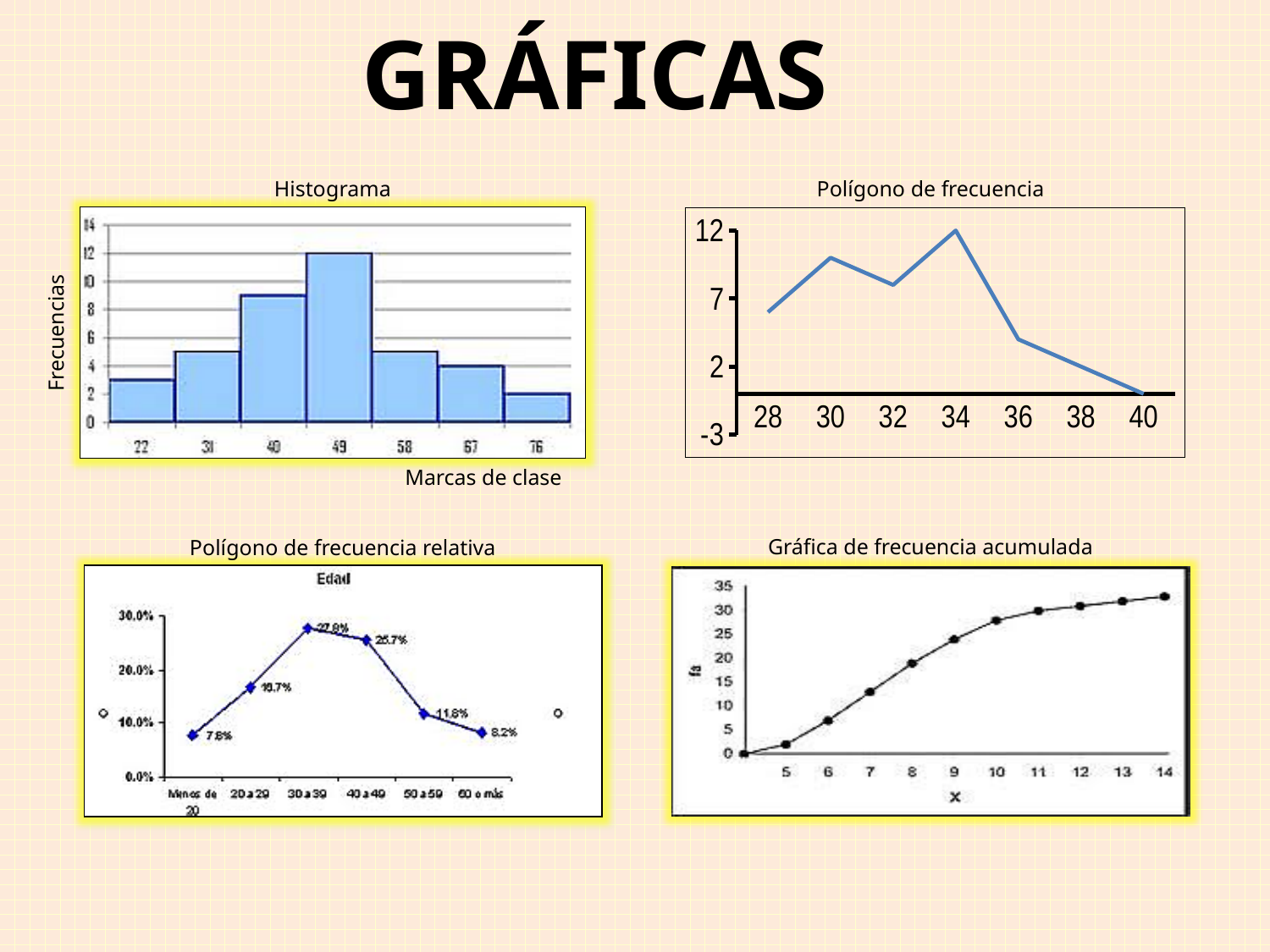
In the Polígono de frecuencia relativa chart, what is the value for the 30 a 39 group? 27.8% In the Histograma chart, what is the frequency for the class mark 49? 12 In the Histograma chart, how many bars are plotted? 7 In the Polígono de frecuencia relativa chart, which age group has the lowest value? Menos de 20 In the Polígono de frecuencia chart, is the value at x = 36 greater or less than 7? less In the Histograma chart, which class mark has the lowest frequency? 76 In the Gráfica de frecuencia acumulada chart, do the values rise or fall as x increases? rise In the Gráfica de frecuencia acumulada chart, is the value at x = 9 greater or less than 20? greater What kind of chart is the Histograma chart? bar chart In the Histograma chart, which class mark has the highest frequency? 49 In the Polígono de frecuencia chart, at which x value does the line reach its highest point? 34 In the Polígono de frecuencia relativa chart, which is larger: the value for 20 a 29 or the value for 50 a 59? 20 a 29